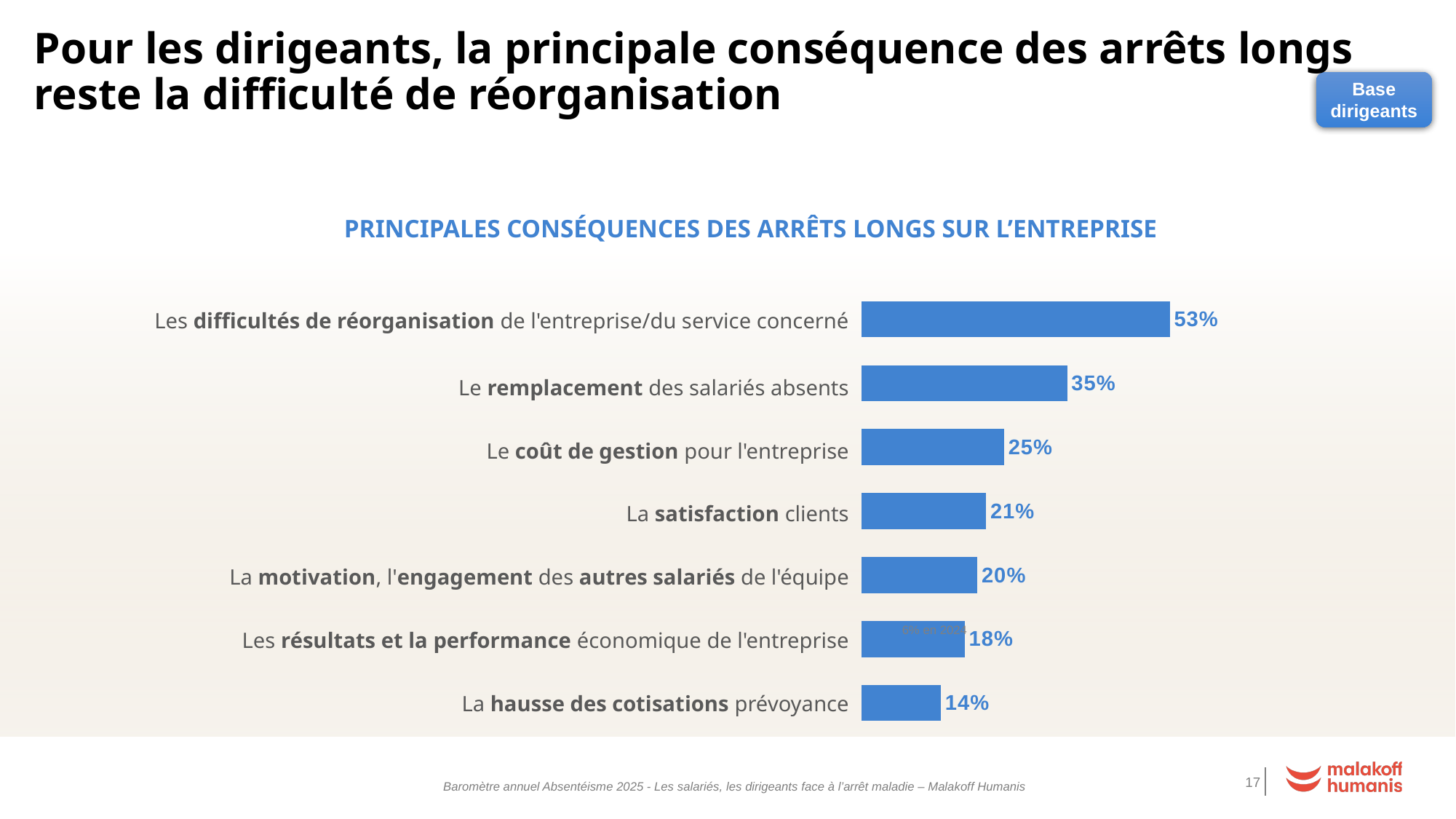
What kind of chart is shown on the slide? Bar chart What is the value for "La satisfaction clients"? 21% What is the value for "Les difficultés de réorganisation de l'entreprise/du service concerné"? 53% What is the value for "Le remplacement des salariés absents"? 35% Which is larger: the value for "Le coût de gestion pour l'entreprise" or the value for "La satisfaction clients"? Le coût de gestion pour l'entreprise What is the title of the chart? PRINCIPALES CONSÉQUENCES DES ARRÊTS LONGS SUR L'ENTREPRISE What is the difference between the values for "Les difficultés de réorganisation" and "Le remplacement des salariés absents"? 18% What is the difference between the values for "La motivation, l'engagement des autres salariés de l'équipe" and "Les résultats et la performance économique de l'entreprise"? 2% Which category has the highest value? Les difficultés de réorganisation de l'entreprise/du service concerné Which category has the lowest value? La hausse des cotisations prévoyance What is the value for "La hausse des cotisations prévoyance"? 14% How many categories are shown in the chart? 7